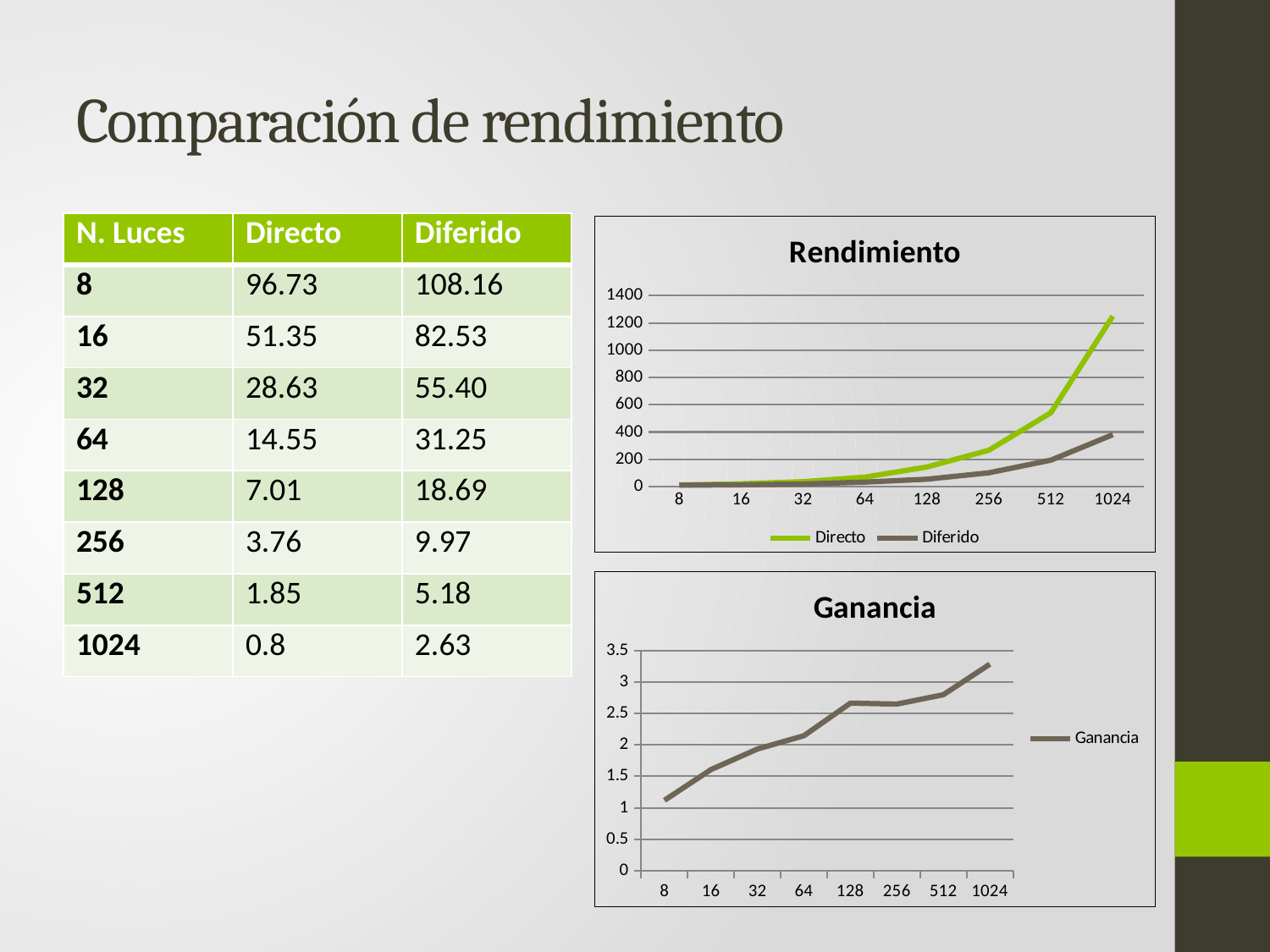
What kind of chart is the "Rendimiento" chart? line chart How many series does the legend of the "Rendimiento" chart list? 2 In the "Ganancia" chart, is the value at 8 greater or less than 1.5? less In the "Ganancia" chart, at which x-axis value is the Ganancia lowest? 8 In the "Ganancia" chart, is the value at 1024 greater or less than 3? greater In the "Rendimiento" chart, at which x-axis value does the Directo series reach its highest point? 1024 How many series does the legend of the "Ganancia" chart list? 1 In the "Rendimiento" chart, how many points are plotted along the x axis for each series? 8 In the "Rendimiento" chart, at 1024, which series has the larger value, Directo or Diferido? Directo In the "Rendimiento" chart, is the value of Directo at 1024 greater or less than 1000? greater In the "Rendimiento" chart, do the values rise or fall as the number of lights increases along the x axis? rise